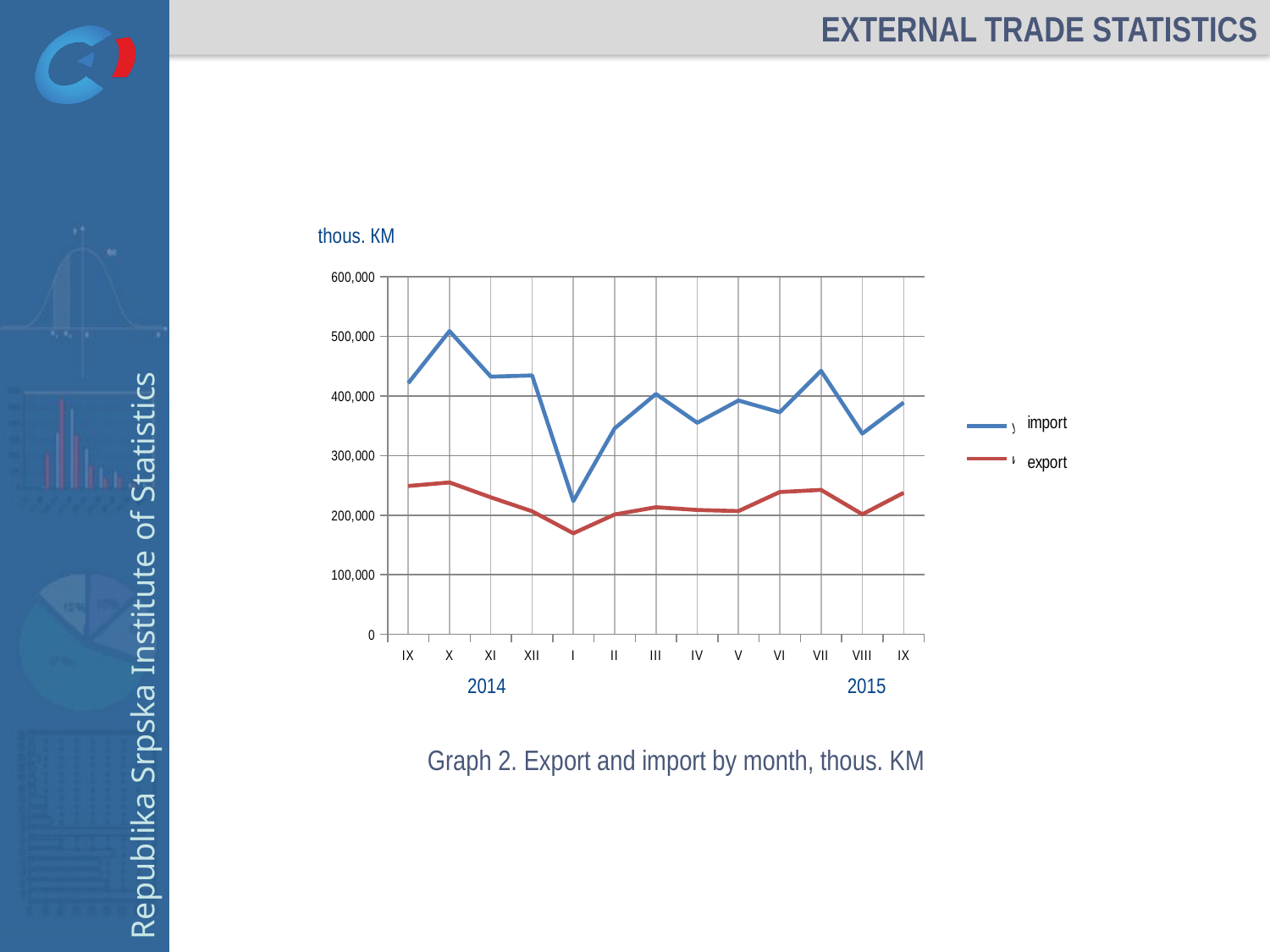
In which month is the import value highest? X 2014 How many series does the legend list? 2 Is the import value for VII 2015 greater or less than 400,000? greater Which is larger in IX 2015, import or export? import Is the export value for I 2015 greater or less than 200,000? less In which month is the import value lowest? I 2015 Is the import value for I 2015 greater or less than 300,000? less Which colour is used for the export line? red How many monthly points are plotted for each series? 13 In which month is the export value lowest? I 2015 Does the import value rise or fall from XII 2014 to I 2015? fall What kind of chart is shown on the slide? line chart